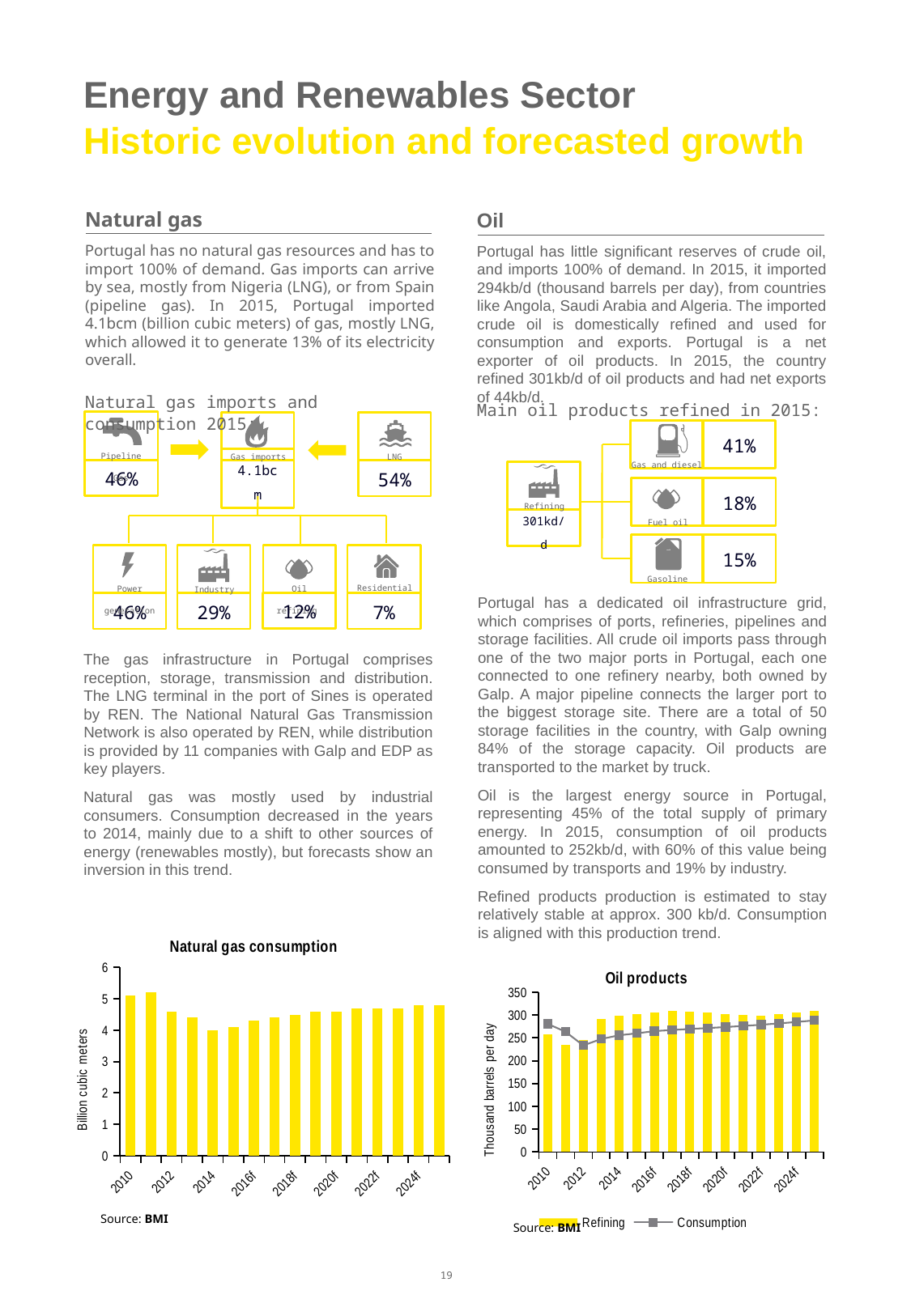
How many series does the legend of the 'Oil products' chart list? 2 In the 'Oil products' chart, does the Consumption line rise or fall from 2012 to 2025f? rise In the 'Oil products' chart, is the Consumption value for 2012 greater or less than 250? less In the 'Oil products' chart, is the Refining value for 2015 greater or less than 250? greater In the 'Natural gas consumption' chart, is the value for 2014 greater or less than 5? less What are the two series named in the legend of the 'Oil products' chart? Refining and Consumption In the 'Oil products' chart, which is larger in 2010, Refining or Consumption? Consumption What unit is shown on the y axis of the 'Natural gas consumption' chart? Billion cubic meters In the 'Natural gas consumption' chart, do the values rise or fall from 2014 to 2025f? rise What type of chart is the 'Natural gas consumption' chart? Bar chart In the 'Natural gas consumption' chart, do the values rise or fall from 2010 to 2014? fall